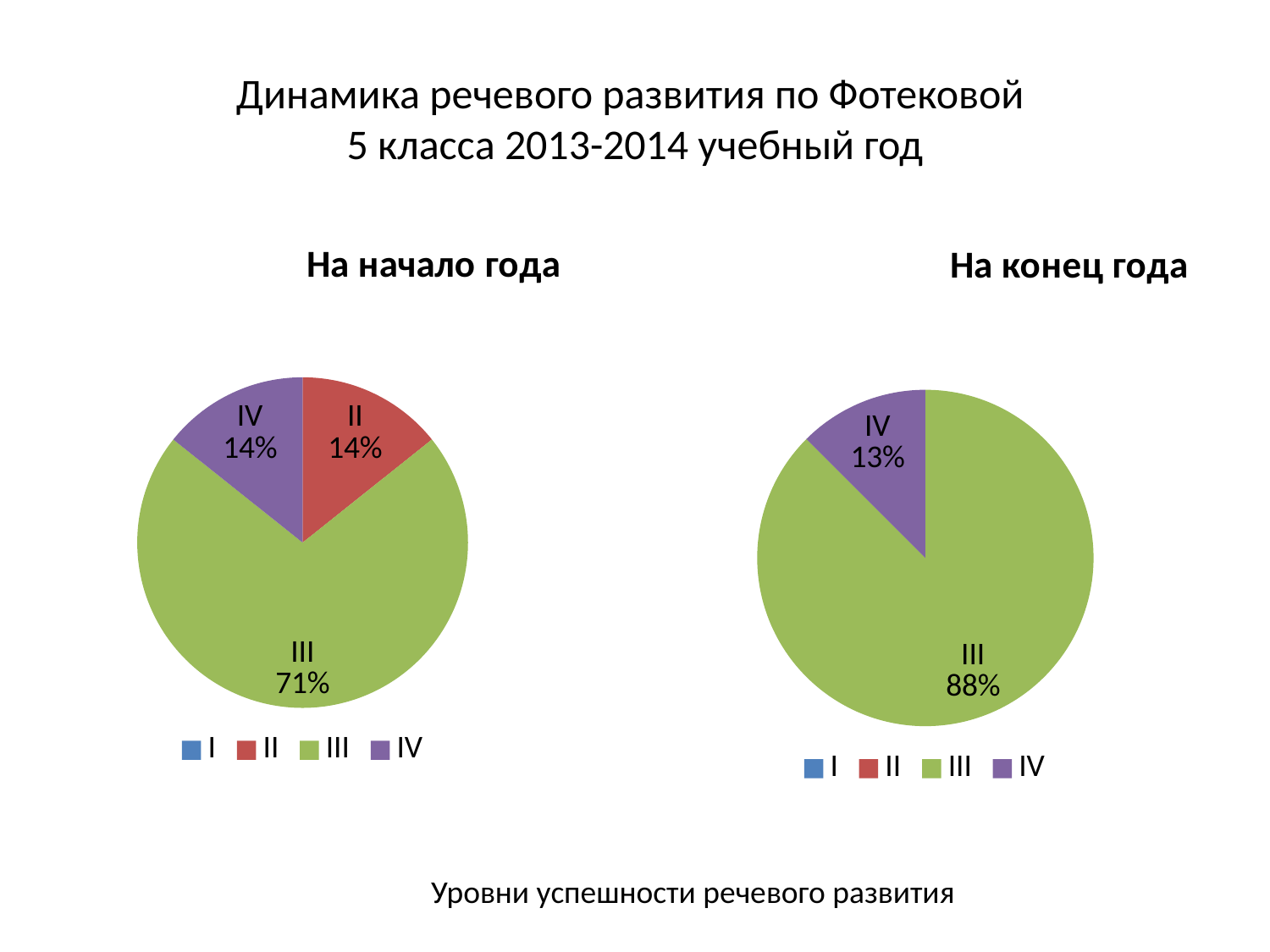
In the chart titled "На начало года", what colour is the slice for level II? Red In the chart titled "На конец года", what share does level III have? 88% In the chart titled "На начало года", what is the difference between the shares of level III and level IV? 57% In the chart titled "На начало года", what share does level II have? 14% What type of chart is the chart titled "На конец года"? Pie chart In the chart titled "На конец года", which level has the smallest visible slice? IV How many entries does the legend of the chart titled "На начало года" list? 4 In the chart titled "На начало года", which level has the largest slice? III In the chart titled "На конец года", what share does level IV have? 13% In the chart titled "На начало года", what share does level III have? 71% Which is larger: the share of level IV in the chart "На начало года" or the share of level IV in the chart "На конец года"? На начало года What is the difference between the share of level III in the chart "На конец года" and the share of level III in the chart "На начало года"? 17%